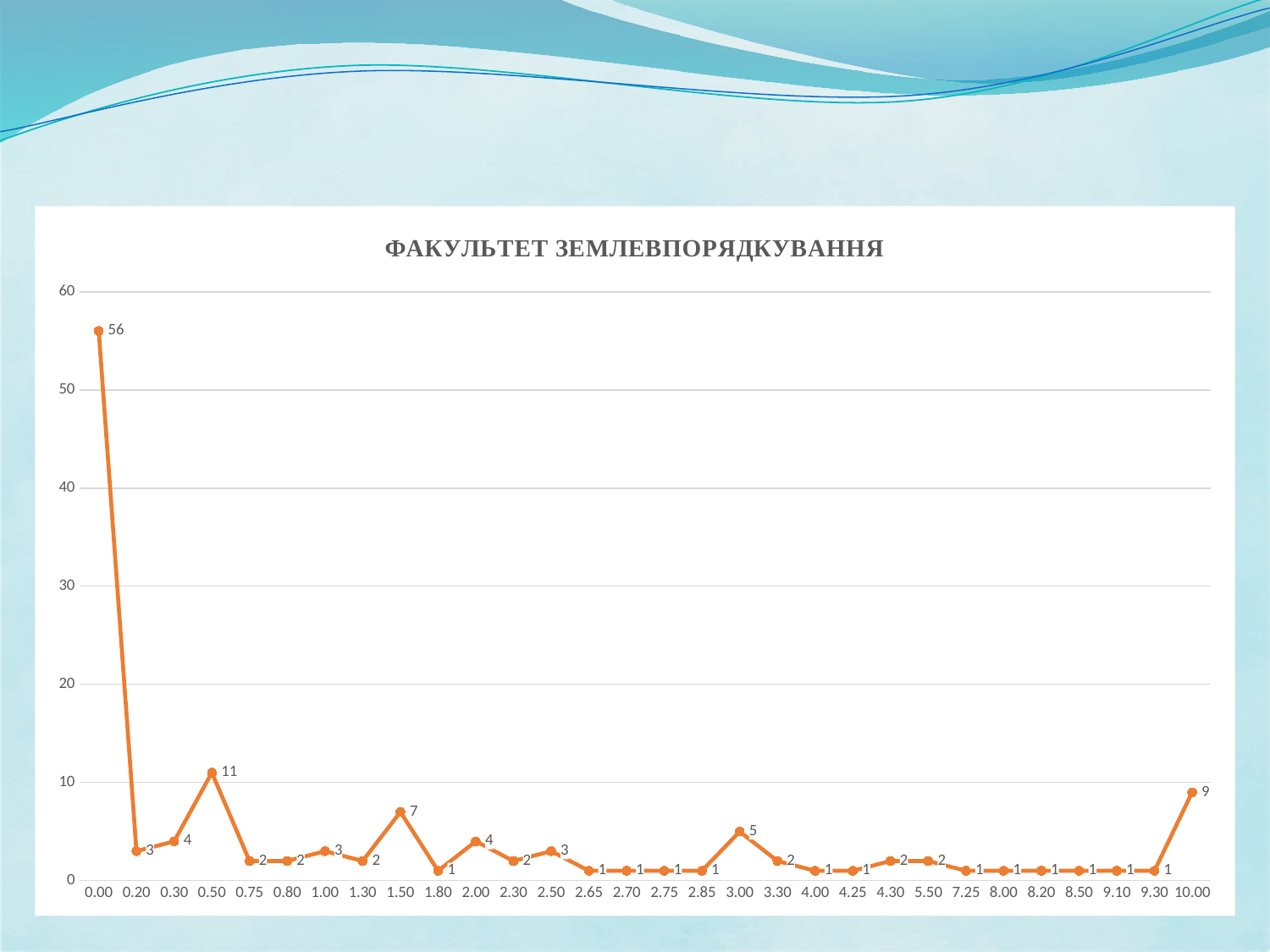
What is the value at 3.00? 5 What kind of chart is this? line chart What is the title of the chart? ФАКУЛЬТЕТ ЗЕМЛЕВПОРЯДКУВАННЯ Is the value at 0.00 greater or less than 50? greater What is the value at 0.50? 11 Which category has the highest value? 0.00 How many categories are shown on the x axis? 30 What is the value at 10.00? 9 What is the difference between the values at 0.00 and 0.50? 45 What is the value at 1.50? 7 Which is larger, the value at 0.50 or the value at 10.00? 0.50 What is the value at 0.00? 56